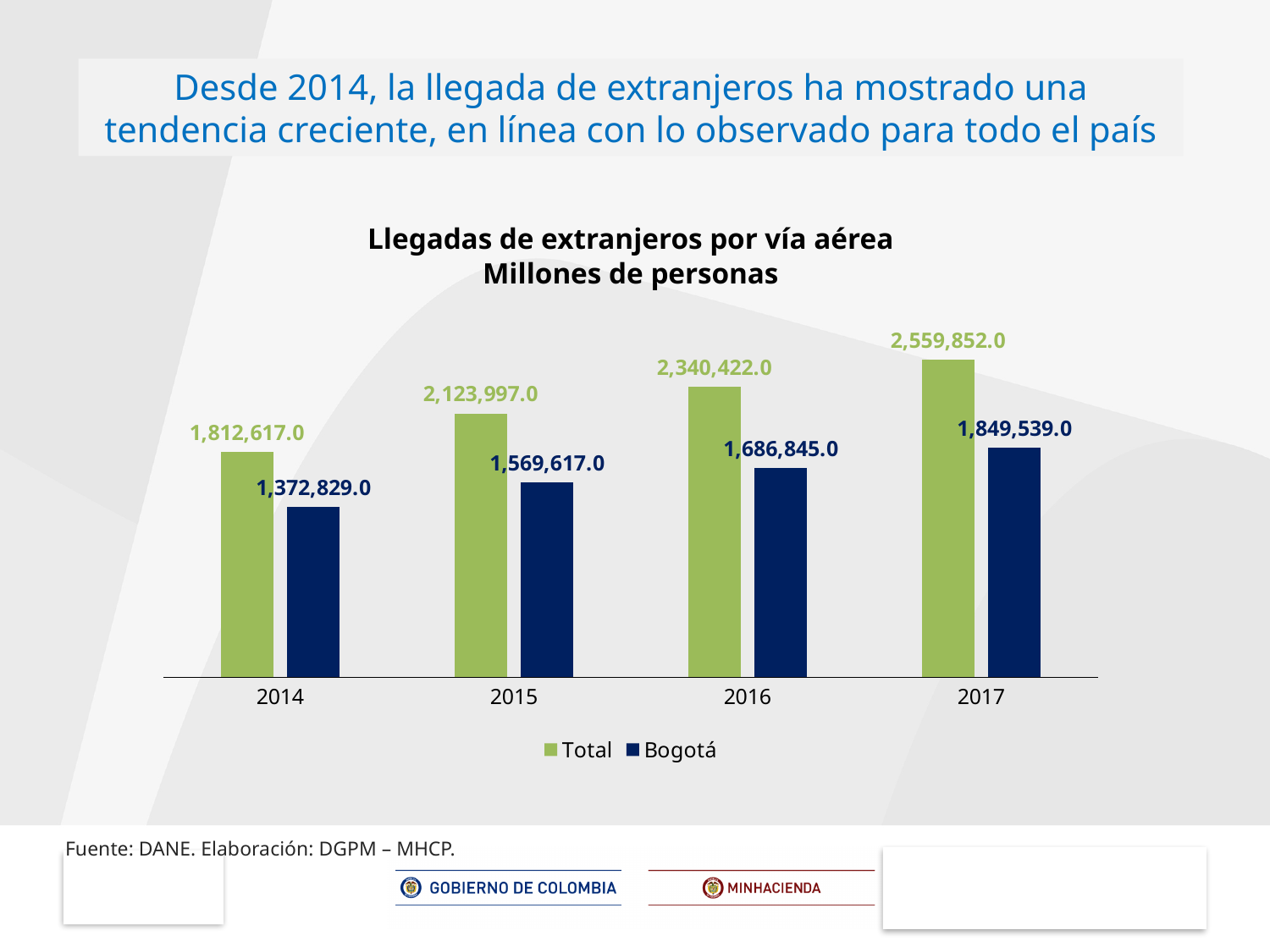
Do the Total values rise or fall from 2014 to 2017? Rise How many series does the legend list? 2 What kind of chart is shown on the slide? Bar chart Which year has the lowest Bogotá value? 2014 What is the Bogotá value for 2017? 1,849,539.0 Which is larger, the Bogotá value in 2016 or the Total value in 2014? Total value in 2014 How many years are shown on the x axis? 4 What is the Total value for 2016? 2,340,422.0 Which year has the highest Total value? 2017 By how much did the Bogotá value increase from 2014 to 2017? 476,710.0 What is the Bogotá value for 2014? 1,372,829.0 What is the difference between the Total and Bogotá values in 2017? 710,313.0